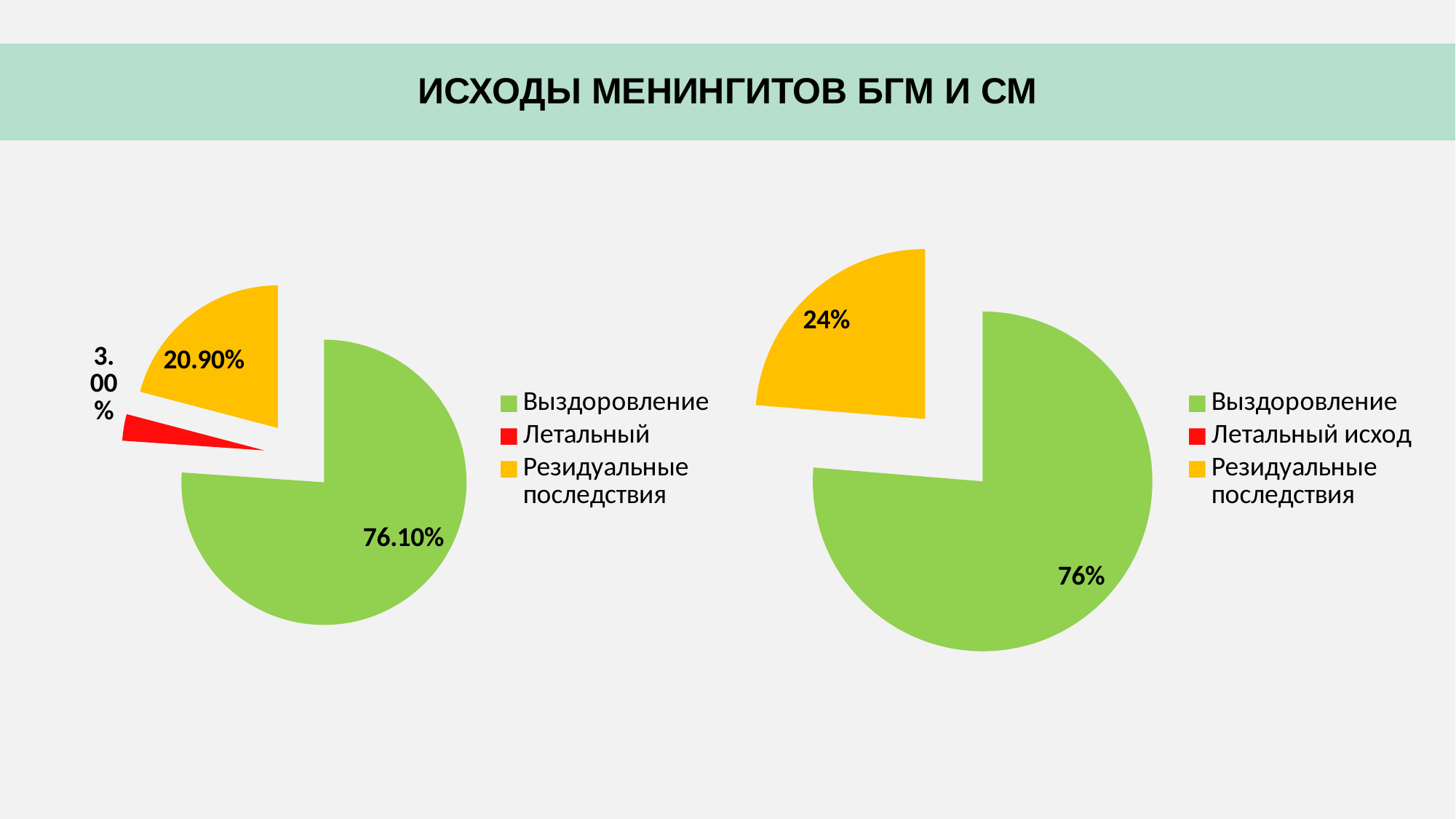
In the left pie chart, what is the value for Летальный? 3.00% In the left pie chart, what is the difference between Выздоровление and Резидуальные последствия? 55.20% In the right pie chart, what is the value for Выздоровление? 76% What type of chart is shown on the left side of the slide? pie chart In the left pie chart, what is the value for Резидуальные последствия? 20.90% In the left pie chart, which category has the largest share? Выздоровление In the left pie chart, what is the value for Выздоровление? 76.10% In the right pie chart, which is larger: Выздоровление or Резидуальные последствия? Выздоровление In the left pie chart, which category has the smallest share? Летальный How many entries does the legend of the right pie chart list? 3 In the right pie chart, what is the value for Резидуальные последствия? 24% What is the title of the slide? ИСХОДЫ МЕНИНГИТОВ БГМ И СМ